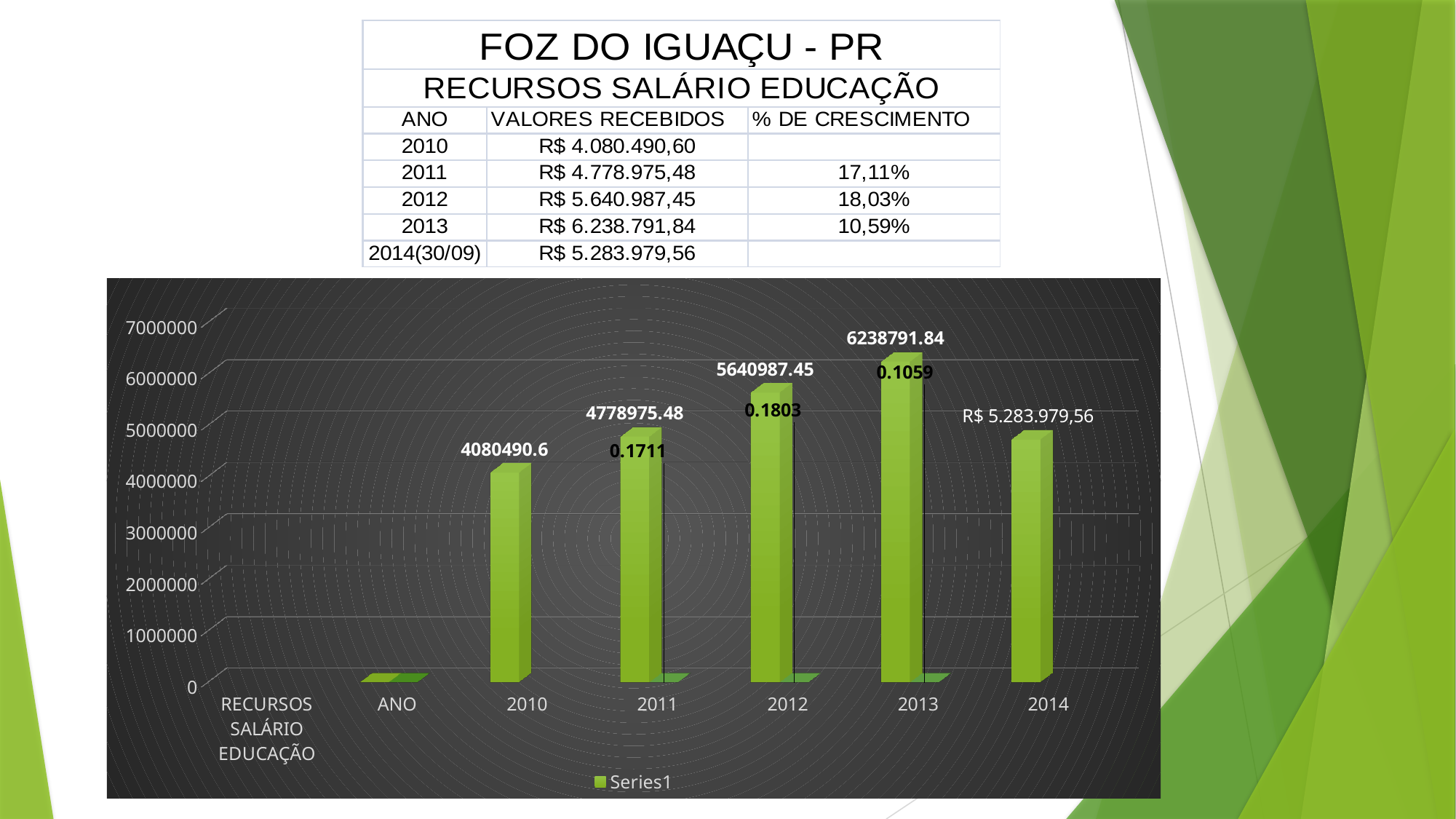
What kind of chart is shown on the slide? bar chart How many series does the legend list? 1 How many category labels are shown along the x axis? 7 Do the values rise or fall from 2010 to 2013? rise What is the difference between the 2013 value and the 2012 value? 597804.39 Which year has the tallest bar in the chart? 2013 What is the data label on the bar for 2010? 4080490.6 Is the bar for 2012 taller or shorter than the bar for 2014? taller What is the data label on the bar for 2013? 6238791.84 Among the years 2010 to 2014, which has the shortest bar? 2010 What is the data label on the bar for 2014? R$ 5.283.979,56